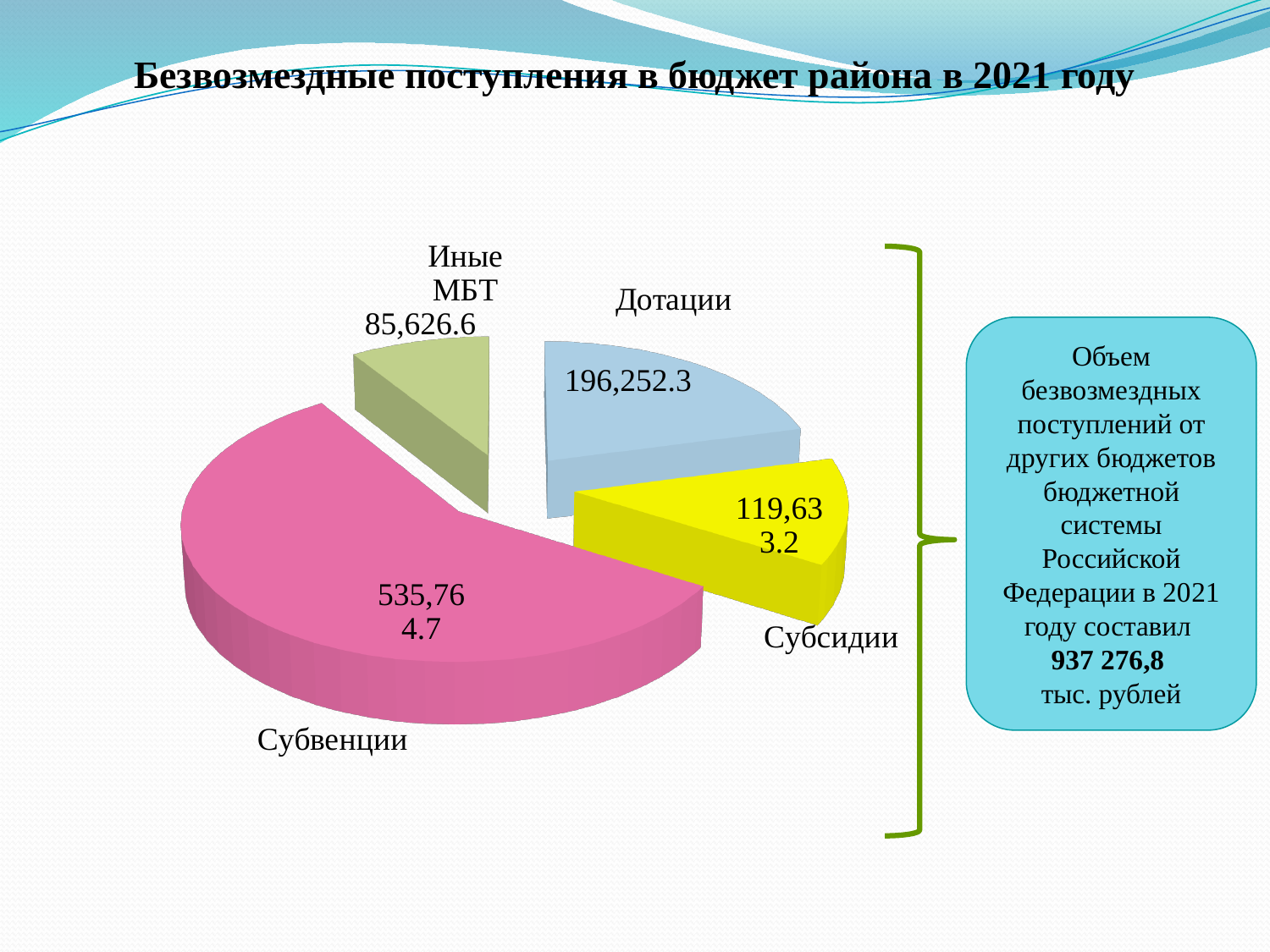
What is the value of the Дотации slice? 196,252.3 What is the difference between the Дотации value and the Субсидии value? 76,619.1 What is the value of the Субвенции slice? 535,764.7 Which category has the largest slice of the pie? Субвенции How many slices does the pie chart have? 4 What is the difference between the Субвенции value and the Иные МБТ value? 450,138.1 What is the title of the slide containing the pie chart? Безвозмездные поступления в бюджет района в 2021 году What is the value of the Субсидии slice? 119,633.2 What type of chart is shown on the slide? Pie chart Which category has the smallest slice of the pie? Иные МБТ Which is larger, Дотации or Субсидии? Дотации What is the value of the Иные МБТ slice? 85,626.6